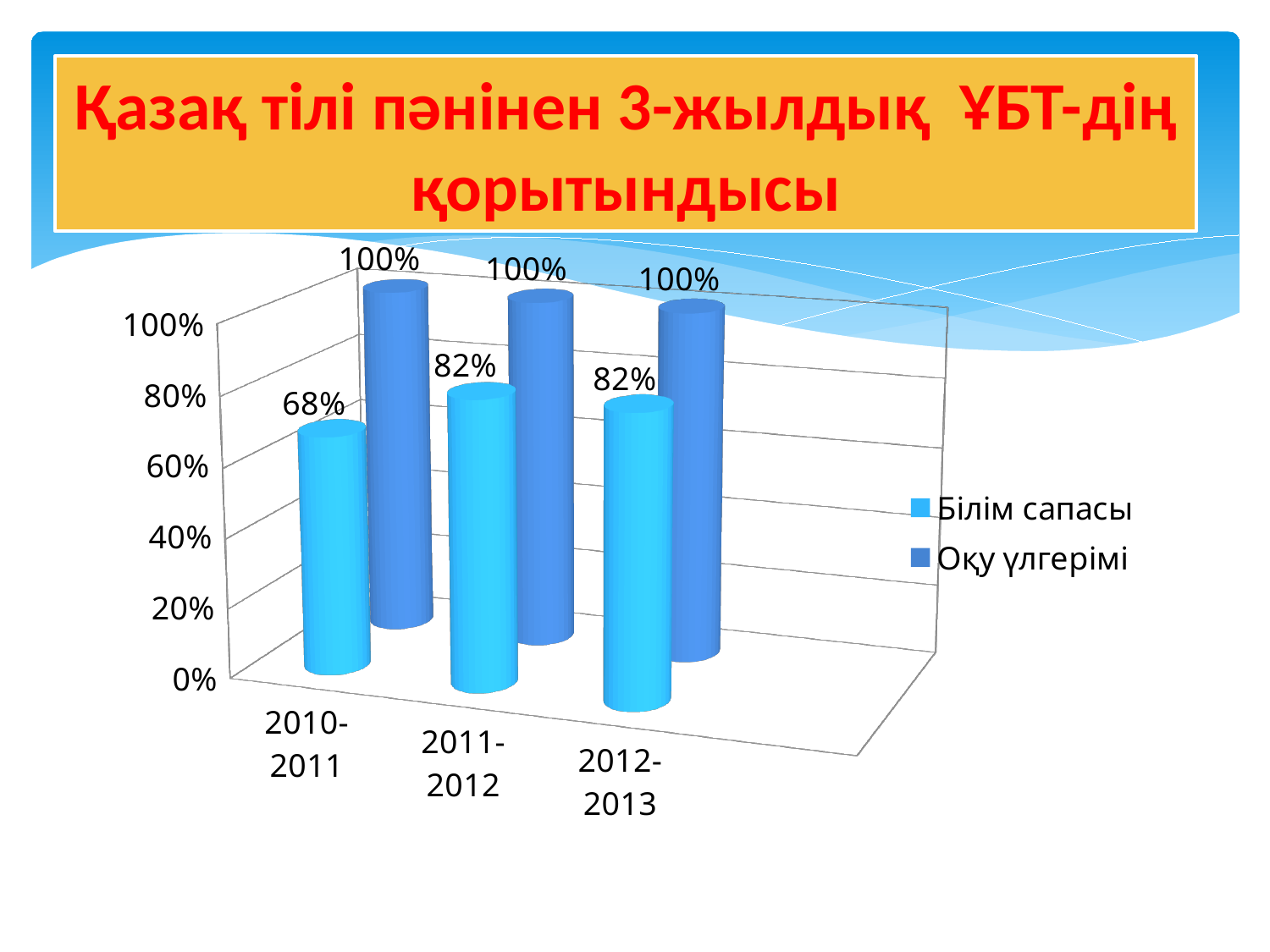
What is the value of Білім сапасы for 2011-2012? 82% What is the difference between Білім сапасы for 2011-2012 and for 2010-2011? 14% What kind of chart is shown on the slide? bar chart Does the value of Оқу үлгерімі change across the three years? No, it stays at 100% Which year has the lowest value for Білім сапасы? 2010-2011 How many series does the legend list? 2 Which is larger: Білім сапасы for 2010-2011 or Білім сапасы for 2012-2013? 2012-2013 What is the difference between Оқу үлгерімі and Білім сапасы for 2010-2011? 32% What is the value of Білім сапасы for 2010-2011? 68% Is the value of Білім сапасы for 2010-2011 greater or less than 80%? less How many year categories are shown on the x axis? 3 What is the value of Оқу үлгерімі for 2012-2013? 100%